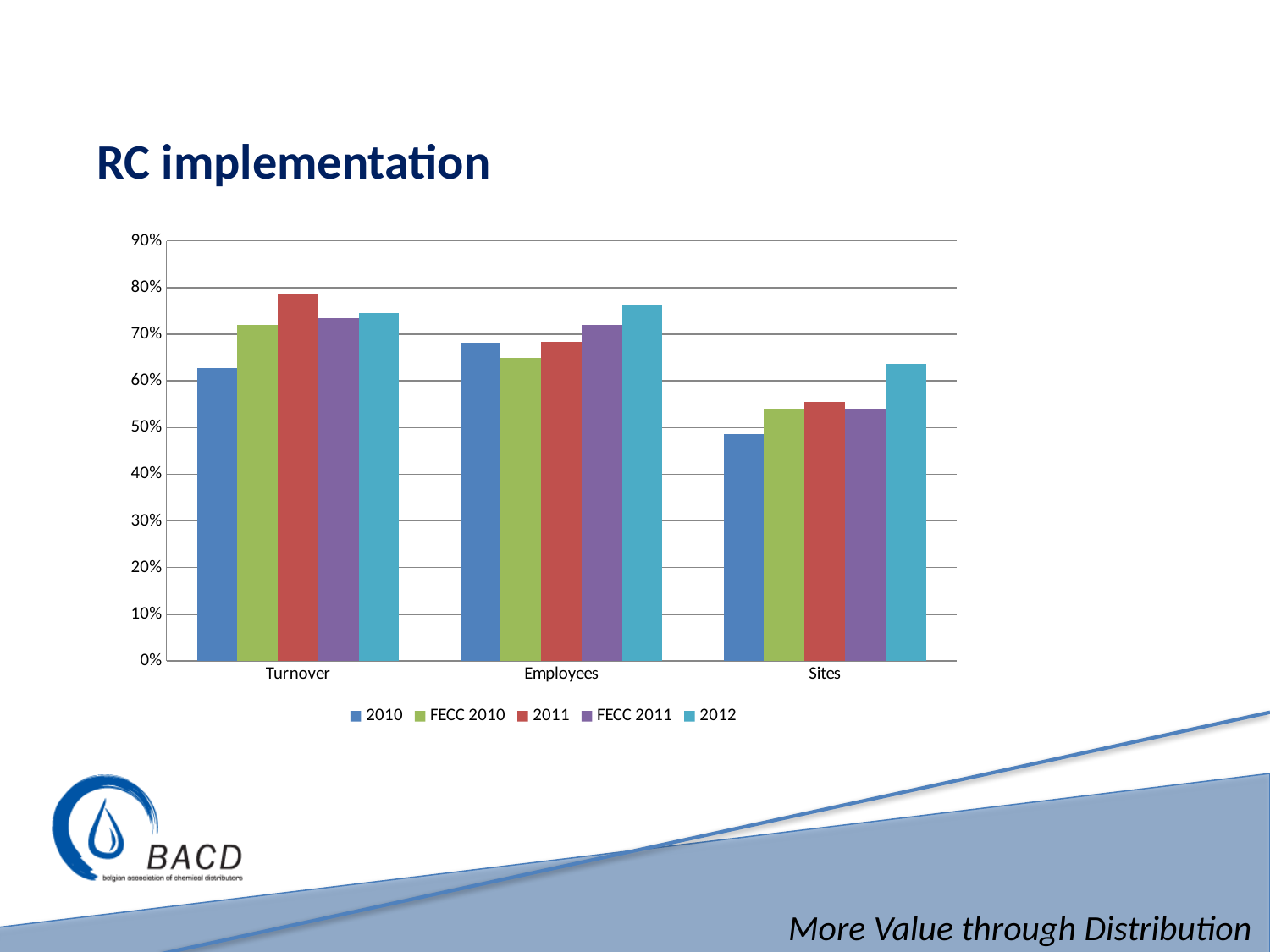
How many series does the legend list? 5 Is the value for 2012 in the Sites category greater or less than 60%? greater How many categories are shown on the x axis? 3 Which series has the lowest value for Turnover? 2010 Is the value for 2010 in the Sites category greater or less than 50%? less Which series has the highest value for Turnover? 2011 Which series has the highest value for Employees? 2012 Which series has the lowest value for Sites? 2010 Is the value for 2011 in the Turnover category greater or less than 70%? greater For the 2012 series, which is larger: Employees or Sites? Employees What is the title of the slide containing the chart? RC implementation What kind of chart is shown on the slide? bar chart